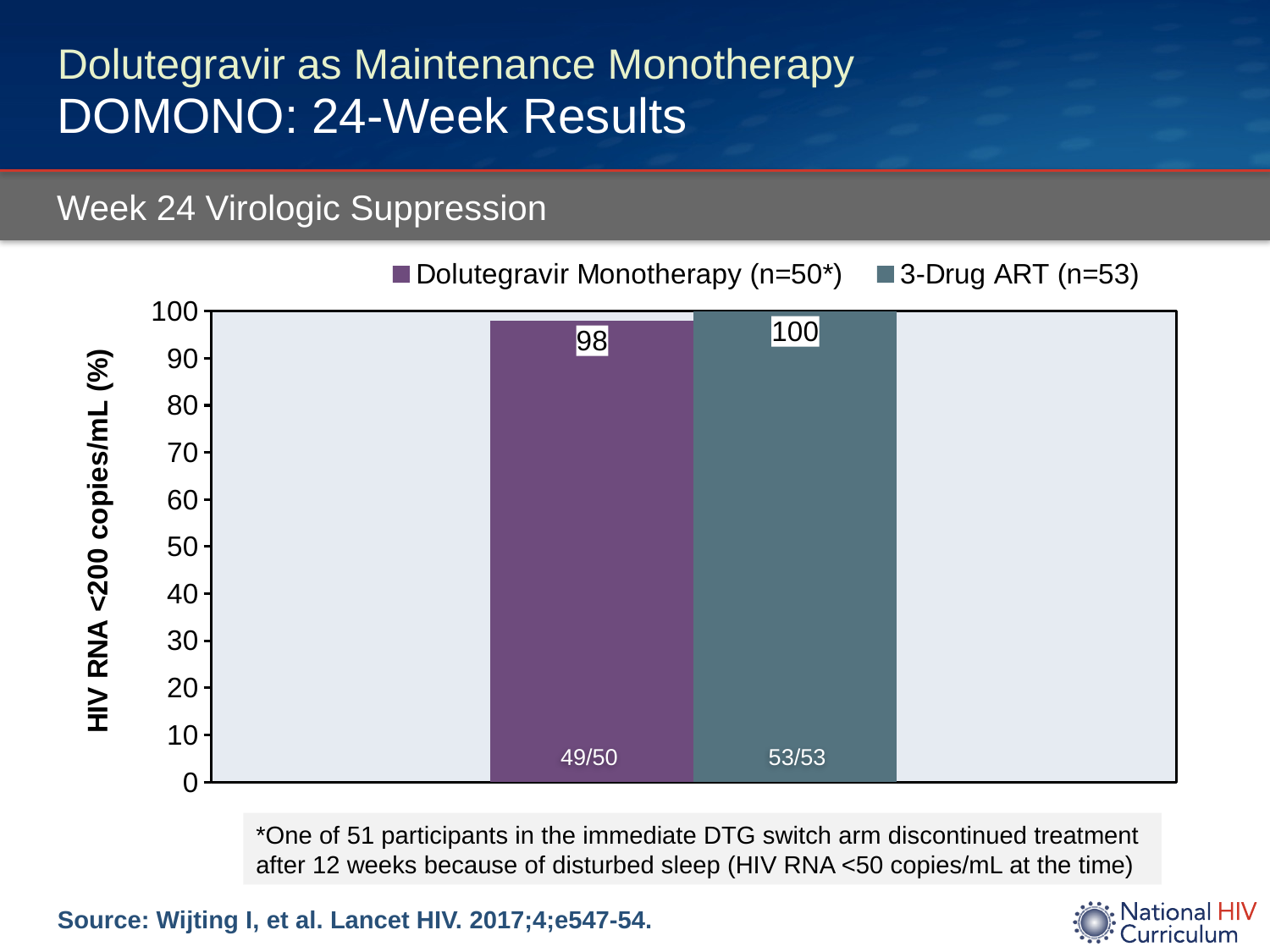
How many series does the legend list? 2 What is the value for Dolutegravir Monotherapy (n=50*)? 98 What is the y-axis label of the chart? HIV RNA <200 copies/mL (%) Is the value for Dolutegravir Monotherapy greater or less than 90? greater What kind of chart is shown? bar chart What is the value for 3-Drug ART (n=53)? 100 What is the difference between the 3-Drug ART value and the Dolutegravir Monotherapy value? 2 What is the maximum value shown on the y axis? 100 What fraction is printed at the base of the Dolutegravir Monotherapy bar? 49/50 What fraction is printed at the base of the 3-Drug ART bar? 53/53 How many bars are plotted in the chart? 2 Which series has the higher value, Dolutegravir Monotherapy or 3-Drug ART? 3-Drug ART (n=53)